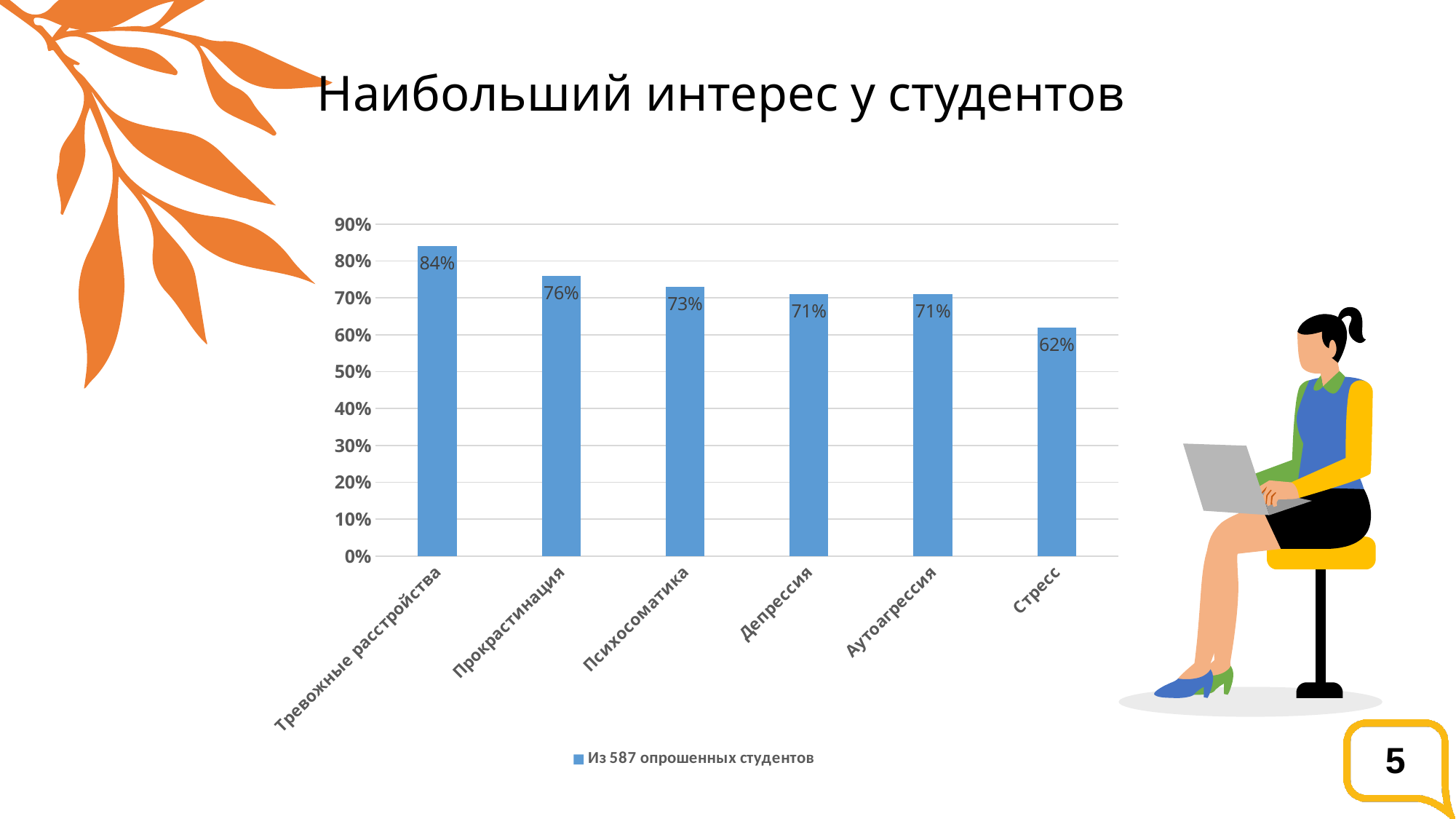
What is the value for Стресс? 62% Which category has the highest value? Тревожные расстройства How many series does the legend list? 1 Which is larger, the value for Прокрастинация or the value for Депрессия? Прокрастинация What is the difference between the values for Тревожные расстройства and Стресс? 22% What is the value for Прокрастинация? 76% How many categories are shown on the chart? 6 What is the legend entry of the chart? Из 587 опрошенных студентов Which category has the lowest value? Стресс What is the value for Тревожные расстройства? 84% What kind of chart is shown on the slide? Bar chart What is the value for Психосоматика? 73%